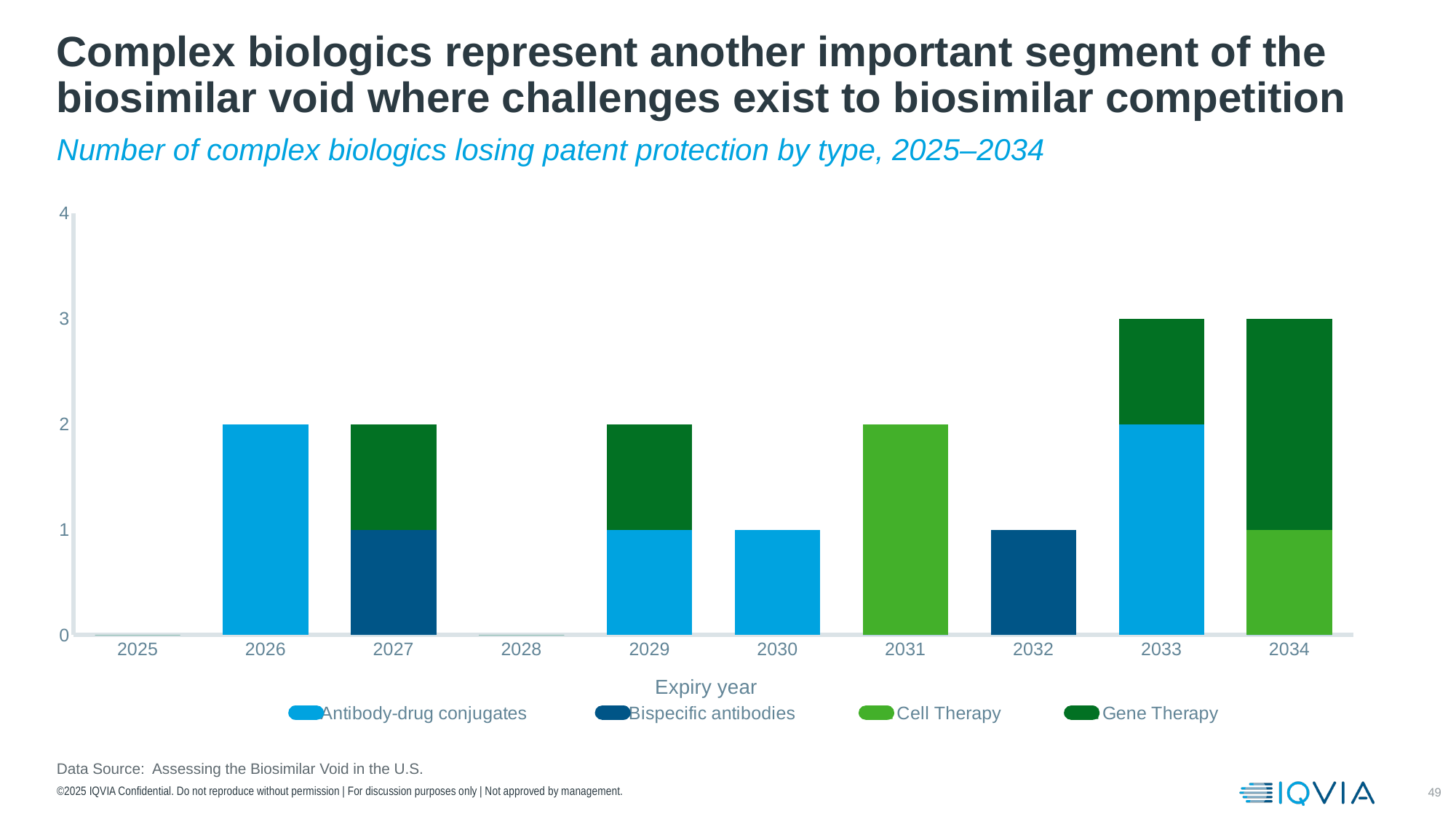
What is the total number of complex biologics losing patent protection in 2033? 3 How many expiry years are shown on the x axis? 10 What is the total number of complex biologics losing patent protection in 2027? 2 How many Gene Therapy products lose patent protection in 2034? 2 How many Antibody-drug conjugates lose patent protection in 2026? 2 What is the label of the x axis? Expiry year What is the difference between the total for 2034 and the total for 2032? 2 Which expiry years have the highest total number of complex biologics losing patent protection? 2033 and 2034 How many Cell Therapy products lose patent protection in 2031? 2 What kind of chart is shown on the slide? Stacked bar chart Which is larger, the total for 2026 or the total for 2030? 2026 How many series does the legend list? 4